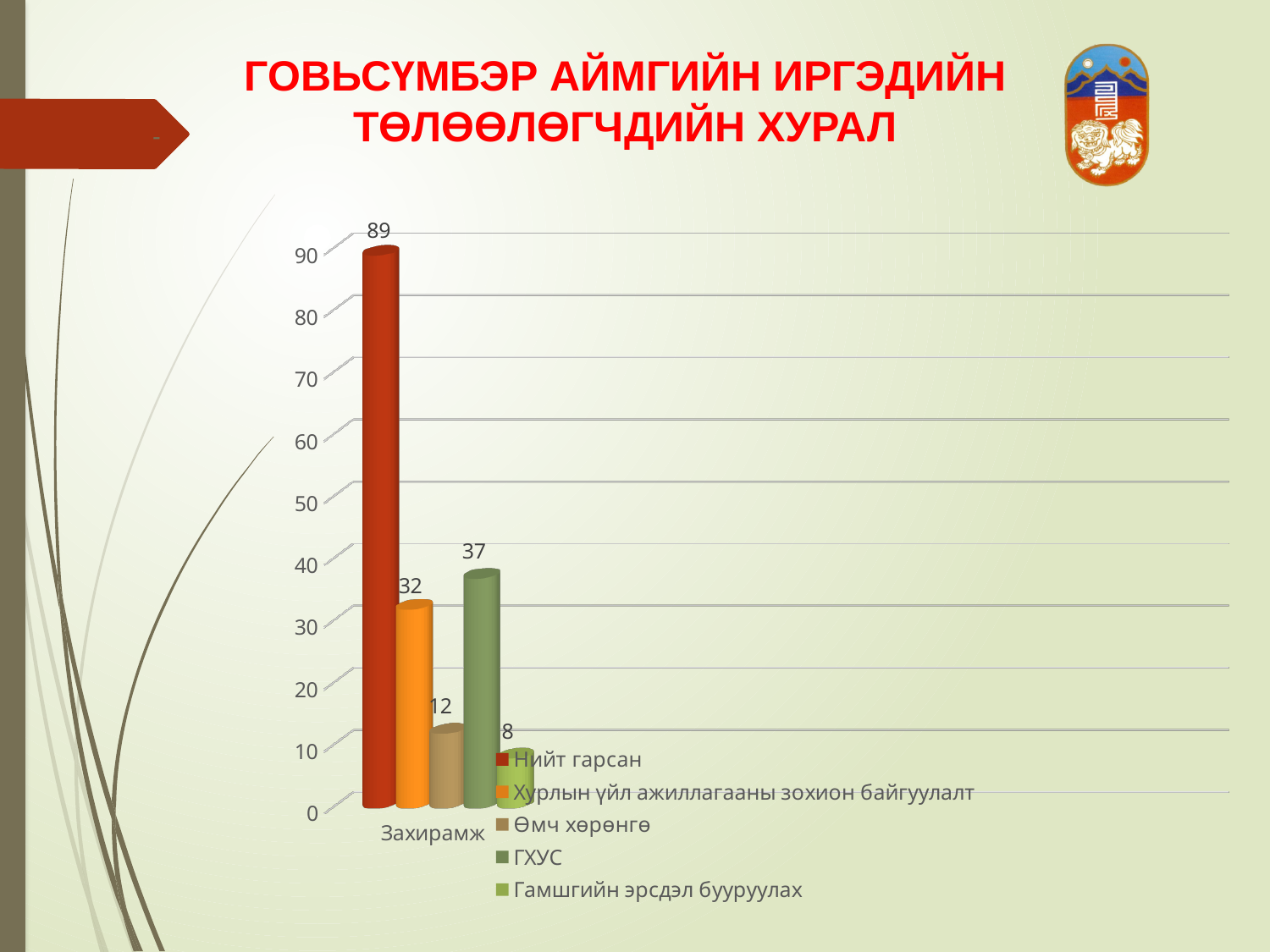
Which is larger, the value for ГХУС or the value for Хурлын үйл ажиллагааны зохион байгуулалт? ГХУС What type of chart is shown on the slide? bar chart What is the value for Гамшгийн эрсдэл бууруулах? 8 What is the value for Өмч хөрөнгө? 12 What is the value for Нийт гарсан in the Захирамж category? 89 What is the category label shown on the x axis? Захирамж What is the difference between the values for Нийт гарсан and ГХУС? 52 Which series has the lowest value? Гамшгийн эрсдэл бууруулах Which series has the highest value? Нийт гарсан What is the value for Хурлын үйл ажиллагааны зохион байгуулалт? 32 What is the value for ГХУС? 37 How many series does the legend list? 5